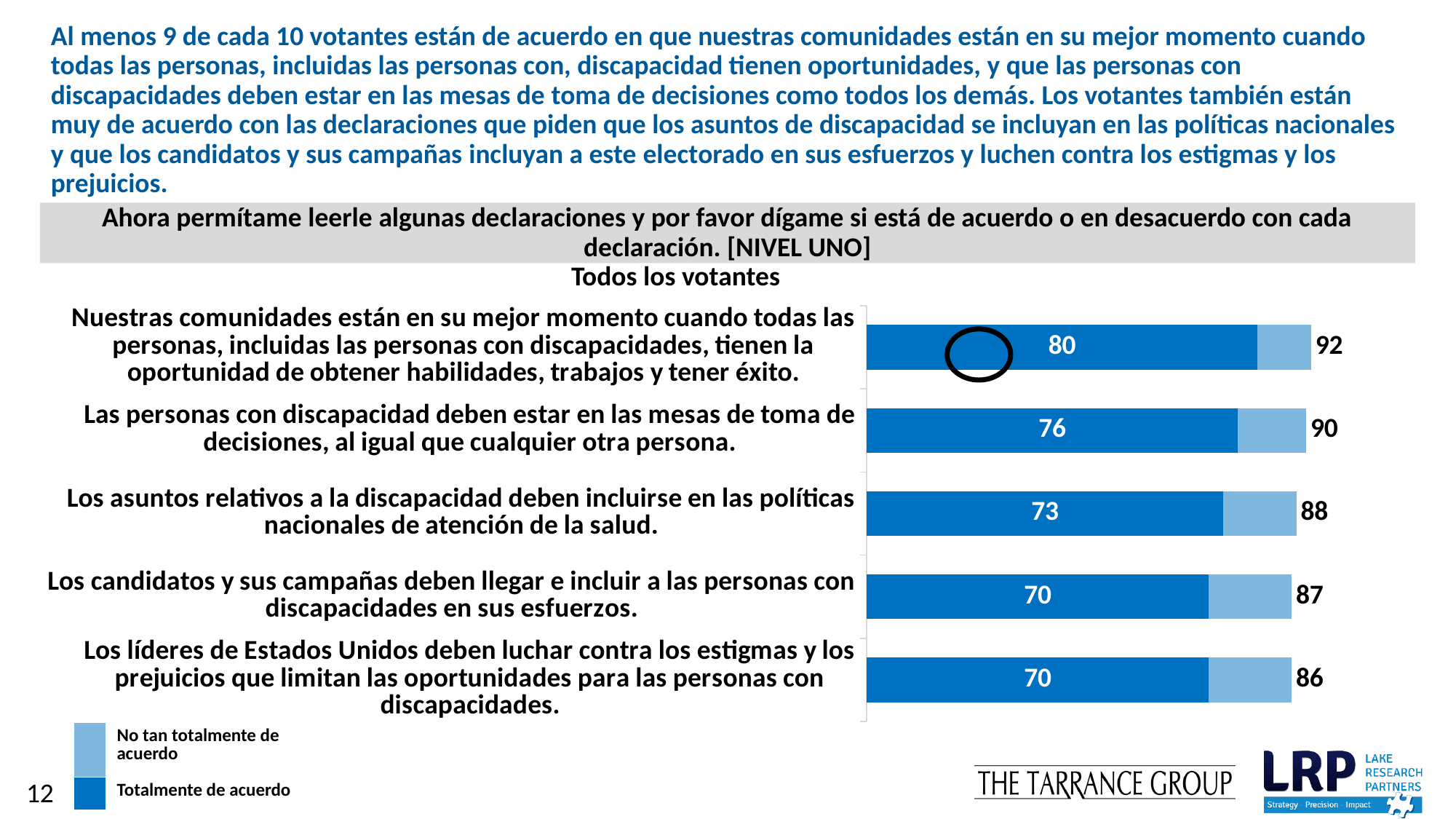
What is the 'Totalmente de acuerdo' value for the statement 'Nuestras comunidades están en su mejor momento cuando todas las personas, incluidas las personas con discapacidades, tienen la oportunidad de obtener habilidades, trabajos y tener éxito'? 80 Based on the printed values, what is the 'No tan totalmente de acuerdo' share for 'Los candidatos y sus campañas deben llegar e incluir a las personas con discapacidades en sus esfuerzos' (total 87 minus 70)? 17 Which statement has the lowest total agreement value? Los líderes de Estados Unidos deben luchar contra los estigmas y los prejuicios que limitan las oportunidades para las personas con discapacidades. Which statement has the highest total agreement value? Nuestras comunidades están en su mejor momento cuando todas las personas, incluidas las personas con discapacidades, tienen la oportunidad de obtener habilidades, trabajos y tener éxito. What kind of chart is shown on the slide? Stacked bar chart Which legend entry is shown in the darker blue colour? Totalmente de acuerdo What is the difference between the total agreement values for the first statement (92) and the last statement (86)? 6 What is the 'Totalmente de acuerdo' value for 'Los asuntos relativos a la discapacidad deben incluirse en las políticas nacionales de atención de la salud'? 73 How many statements (categories) are plotted in the chart? 5 How many series does the legend list? 2 Which is larger: the 'Totalmente de acuerdo' value for 'Las personas con discapacidad deben estar en las mesas de toma de decisiones' or for 'Los asuntos relativos a la discapacidad deben incluirse en las políticas nacionales de atención de la salud'? Las personas con discapacidad deben estar en las mesas de toma de decisiones (76) What is the total agreement value shown at the end of the bar for 'Las personas con discapacidad deben estar en las mesas de toma de decisiones, al igual que cualquier otra persona'? 90